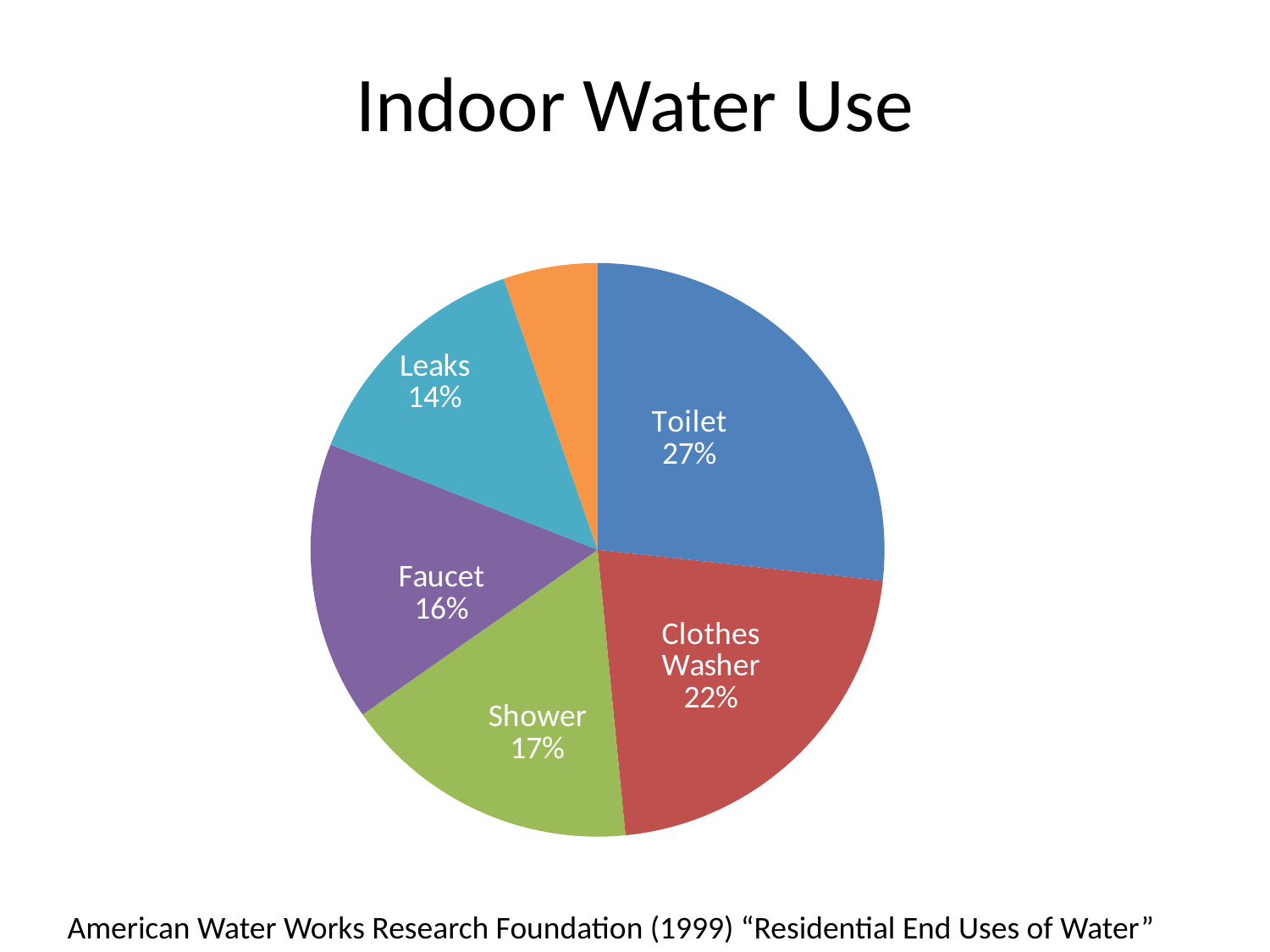
What percentage is shown for Shower? 17% What colour is the Toilet slice? blue What is the title of the chart? Indoor Water Use What kind of chart is shown on the slide? pie chart What percentage is shown for Clothes Washer? 22% What is the difference in percentage points between Toilet and Clothes Washer? 5% Which labeled category has the largest share of indoor water use? Toilet How many slices does the pie chart have? 6 What share of indoor water use does Toilet account for? 27% What percentage is shown for Leaks? 14% What percentage is shown for Faucet? 16% Which has a larger share, Shower or Faucet? Shower